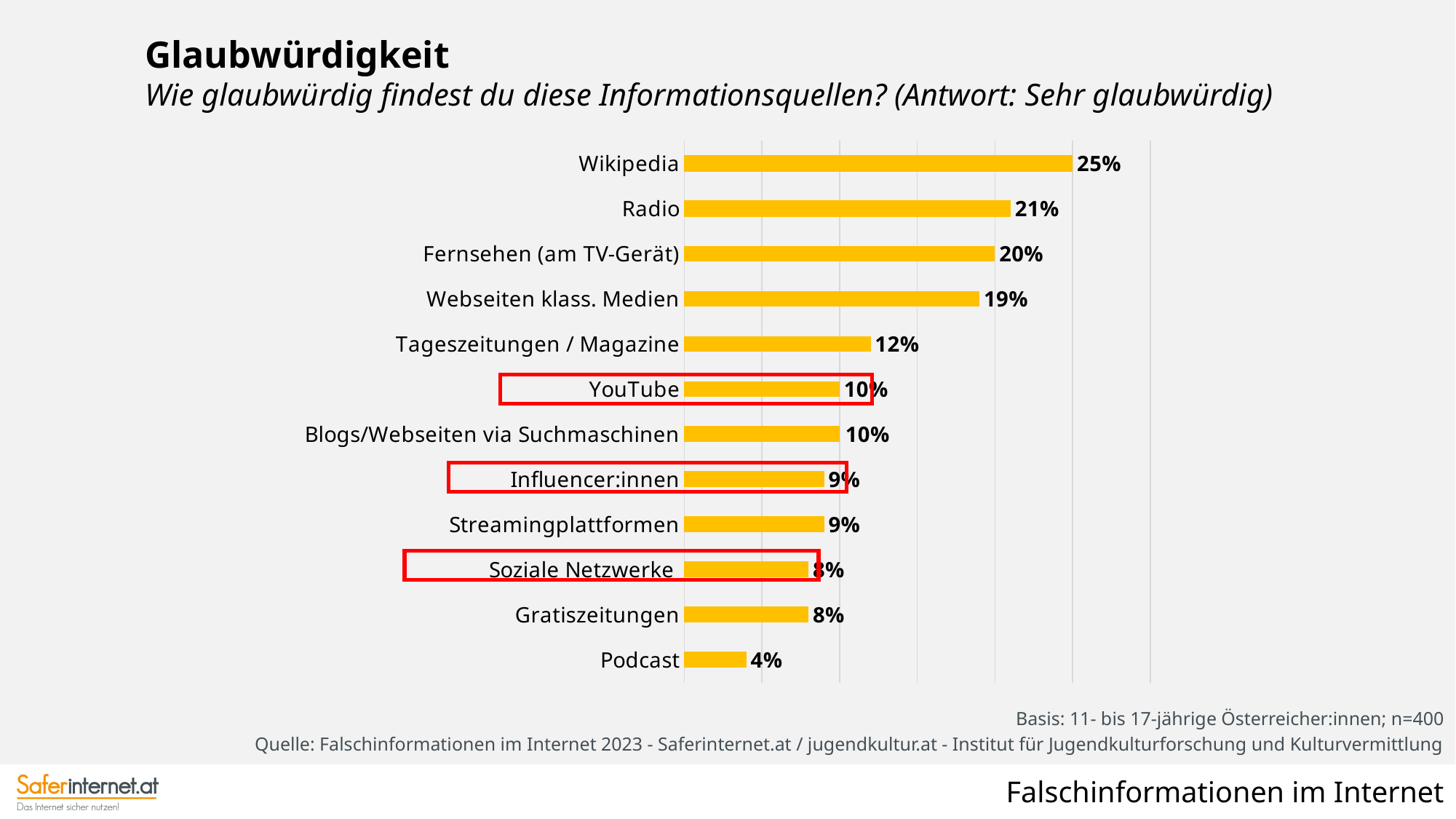
What is the value for Soziale Netzwerke? 8% What is the difference between the values for Wikipedia and Podcast? 21% What is the difference between the values for Radio and Fernsehen (am TV-Gerät)? 1% What is the value for Tageszeitungen / Magazine? 12% How many categories are shown in the chart? 12 What is the value for Wikipedia? 25% What kind of chart is shown on the slide? Bar chart Which three categories are highlighted with red boxes? YouTube, Influencer:innen, Soziale Netzwerke Which category has the highest value? Wikipedia Which is larger, the value for Webseiten klass. Medien or the value for Tageszeitungen / Magazine? Webseiten klass. Medien What is the value for Podcast? 4% Which category has the lowest value? Podcast